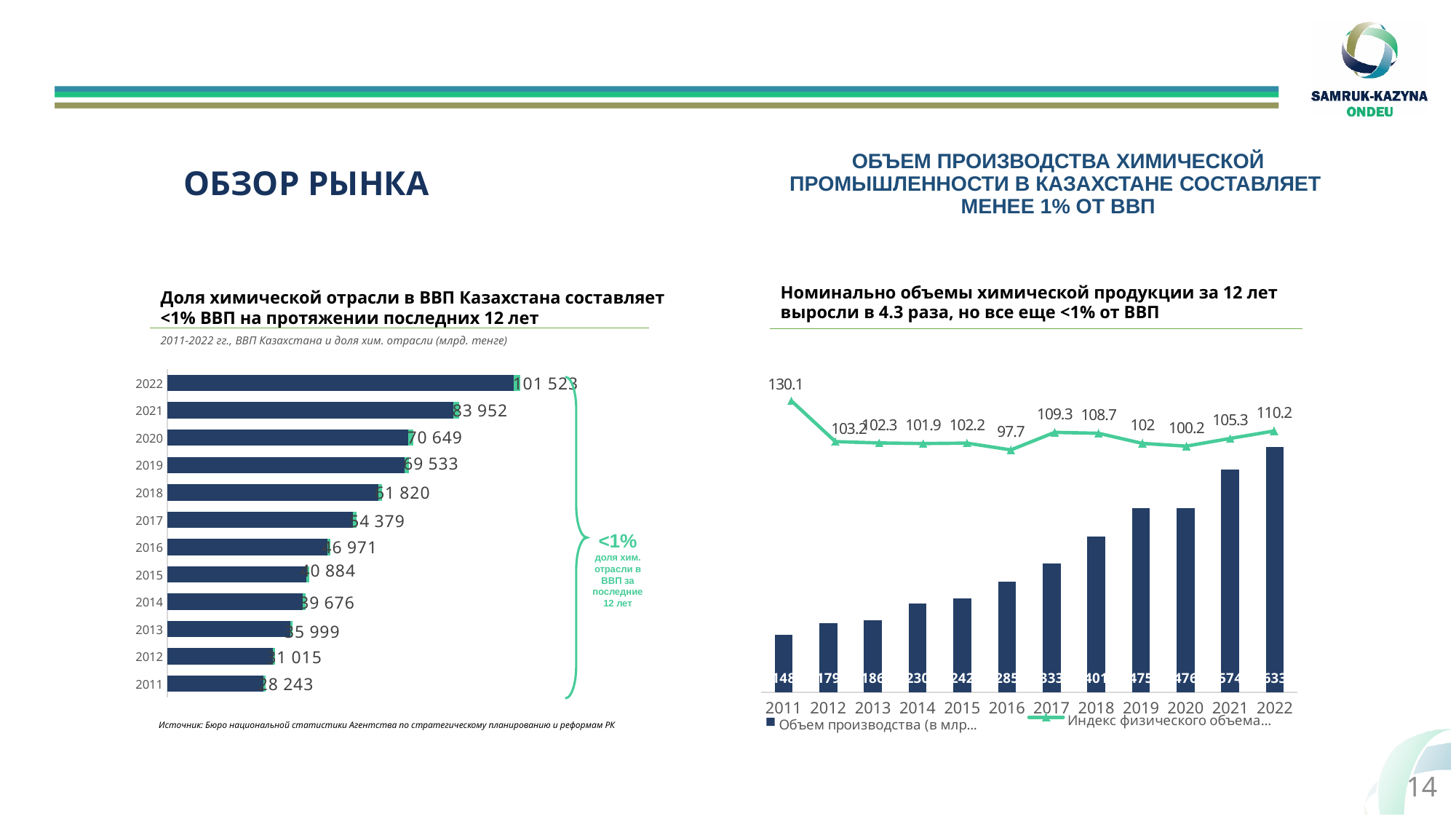
On the right chart (Объем производства), in which year is the Индекс физического объема lowest? 2016 On the left chart (ВВП Казахстана), how many years are shown? 12 On the left chart (ВВП Казахстана), what kind of chart is it? bar chart On the right chart (Объем производства), does the Объем производства series generally rise or fall from 2011 to 2022? rise On the right chart (Объем производства), what is the Объем производства value for 2022? 633 On the right chart (Объем производства), how many series does the legend list? 2 On the left chart (ВВП Казахстана), which year has the highest value? 2022 On the left chart (ВВП Казахстана), what is the value for 2011? 28 243 On the left chart (ВВП Казахстана), what is the value for 2022? 101 523 On the right chart (Объем производства), which year has the higher Индекс физического объема, 2021 or 2022? 2022 On the right chart (Объем производства), what is the Индекс физического объема value for 2011? 130.1 On the left chart (ВВП Казахстана), what is the difference between the 2022 and 2021 values? 17 571